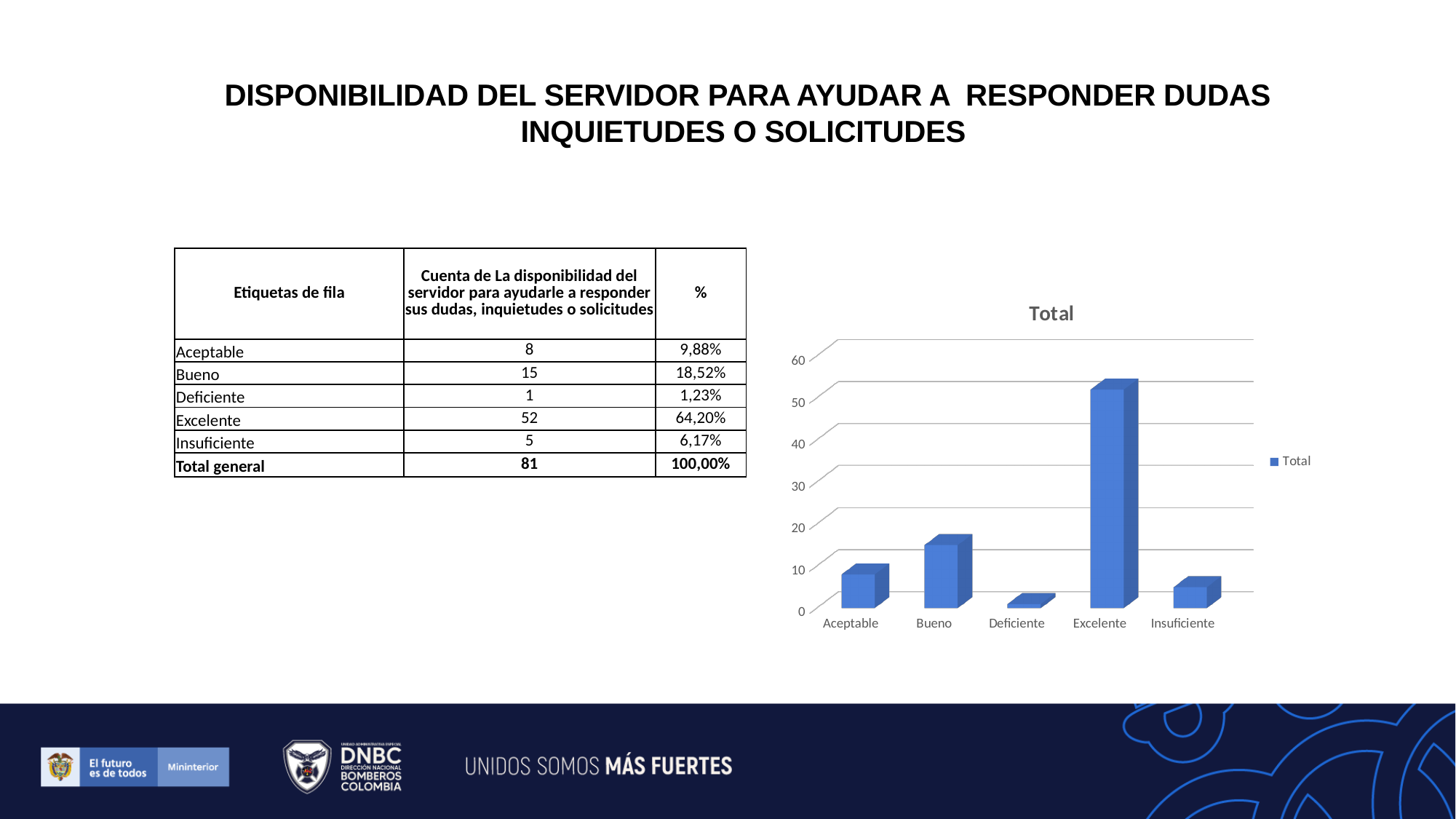
According to the slide, what is the count for Excelente? 52 According to the slide, what is the count for Bueno? 15 How many categories are shown on the x axis of the chart? 5 Which category has the lowest bar in the chart? Deficiente How many series does the chart legend list? 1 What is the difference between the counts for Excelente and Bueno shown on the slide? 37 Which category has the highest bar in the chart? Excelente What is the title of the chart? Total Is the value for Excelente greater or less than 50? greater Is the value for Bueno greater or less than 20? less Which is larger, the value for Aceptable or the value for Insuficiente? Aceptable What kind of chart is shown on the slide? bar chart